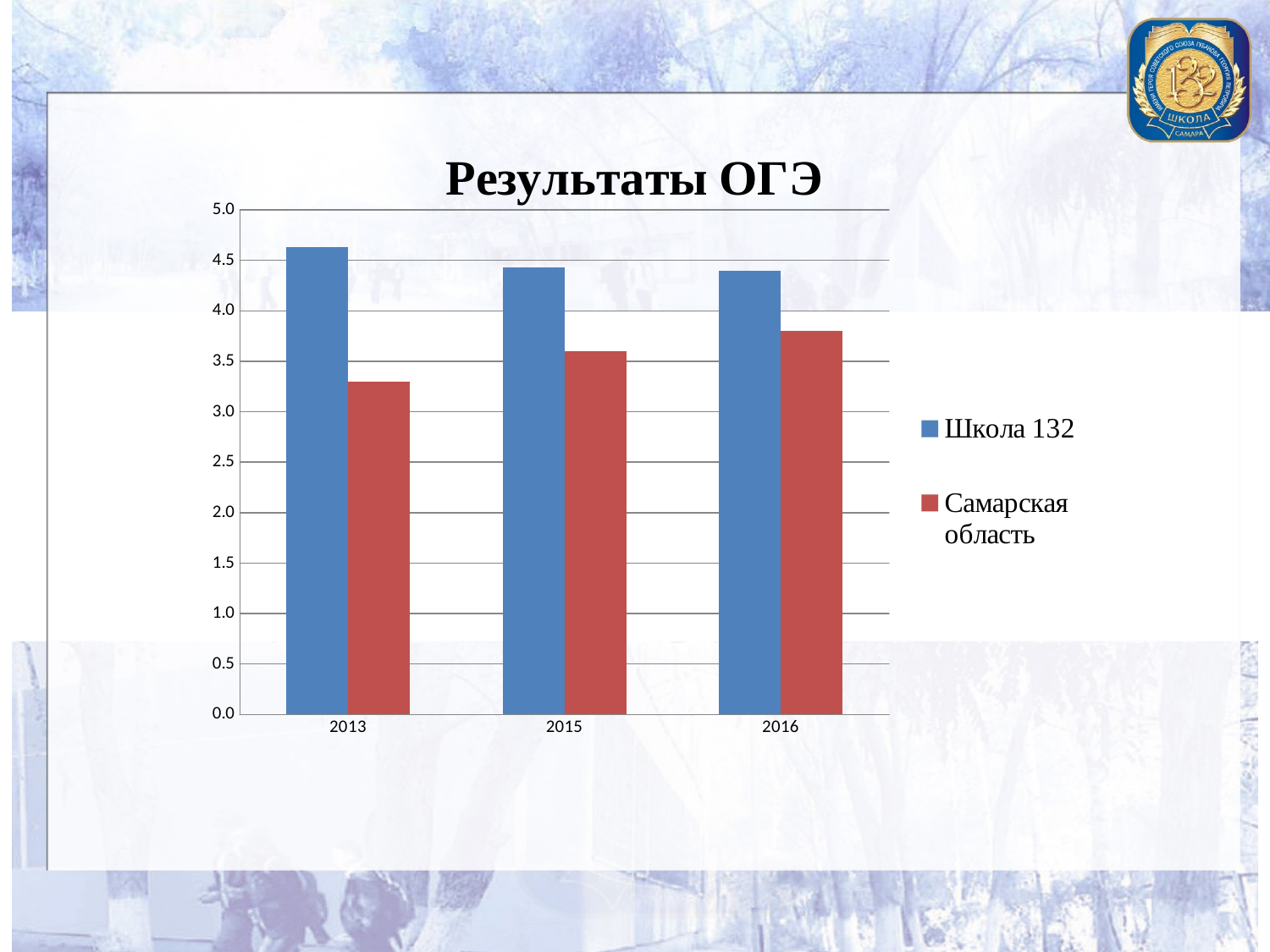
What kind of chart is shown on the slide? bar chart How many years are shown on the x axis? 3 Is the value for Школа 132 in 2013 greater or less than 4.5? greater What is the title of the chart? Результаты ОГЭ Which series is shown in red? Самарская область Is the value for Самарская область in 2013 greater or less than 3.5? less In which year is the value for Самарская область the highest? 2016 In which year is the value for Школа 132 the highest? 2013 In which year is the value for Самарская область the lowest? 2013 Do the values for Самарская область rise or fall from 2013 to 2016? rise How many series does the legend list? 2 Is the value for Самарская область in 2016 greater or less than 4.0? less